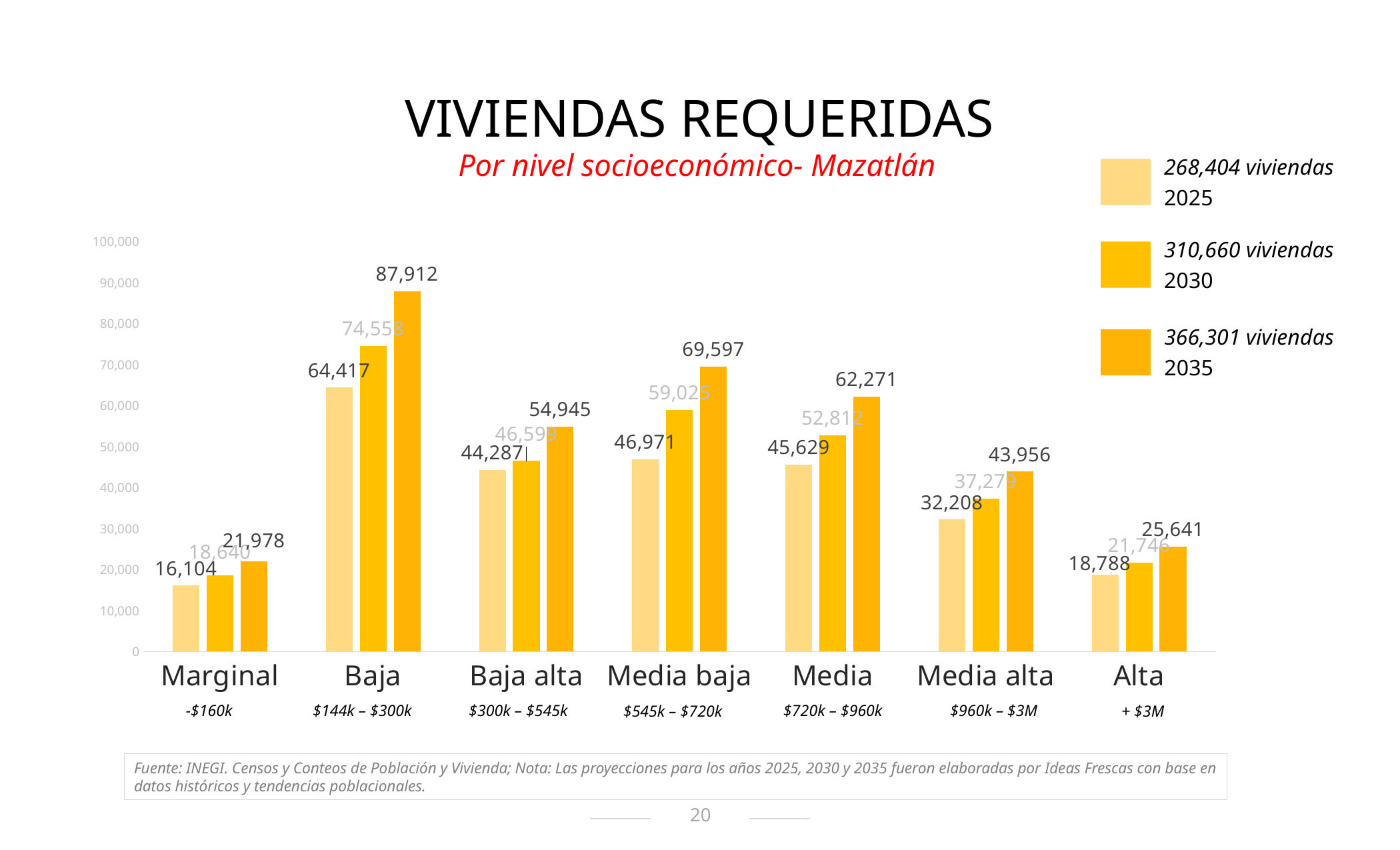
Which category has the highest 2035 value? Baja Is the 2030 value for Alta greater or less than 30,000? less How many socioeconomic categories are shown on the x axis? 7 Which is larger, the 2035 value for Media or the 2035 value for Media baja? Media baja What is the difference between the 2035 and 2025 values for Baja? 23,495 What is the 2030 value for Media alta? 37,279 According to the legend, what is the total number of viviendas for 2030? 310,660 viviendas What is the 2035 value for Baja? 87,912 How many series does the legend list? 3 Which category has the lowest 2025 value? Marginal What type of chart is shown on the slide? Bar chart What is the 2025 value for Media baja? 46,971